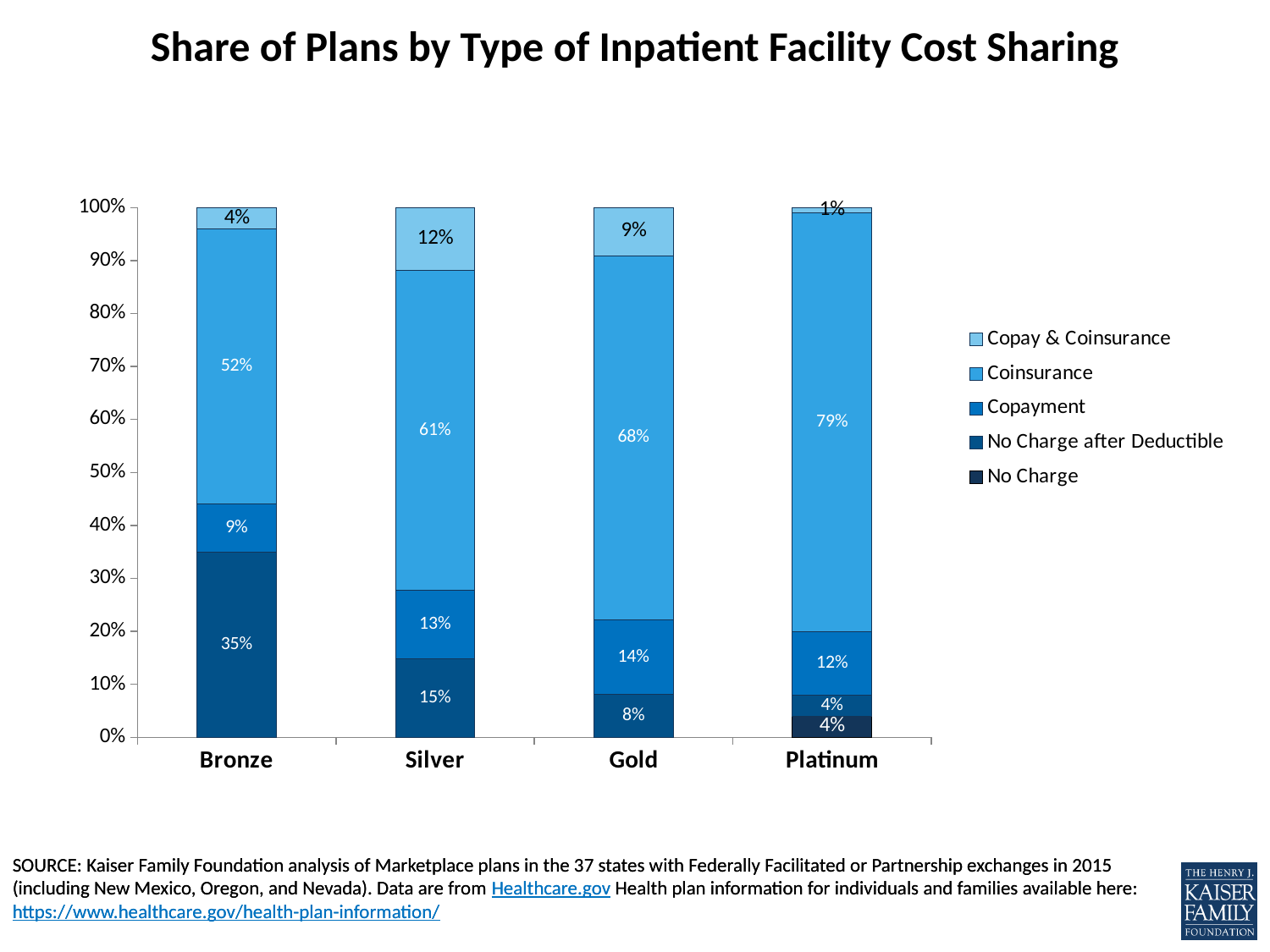
Which has a larger Copayment share, Gold or Platinum? Gold Which plan type has the highest Coinsurance share? Platinum Which plan type has the lowest Copay & Coinsurance share? Platinum How many series does the legend list? 5 What kind of chart is shown on the slide? Stacked bar chart How many percentage points higher is the Coinsurance share for Gold than for Bronze? 16 percentage points How many plan categories are shown on the x axis? 4 What is the value of the bottom segment of the Bronze bar? 35% What is the Copay & Coinsurance share for Gold plans? 9% What is the Coinsurance share for Platinum plans? 79% What is the Copayment share for Silver plans? 13% Does the Coinsurance share rise or fall from Bronze to Platinum? Rises